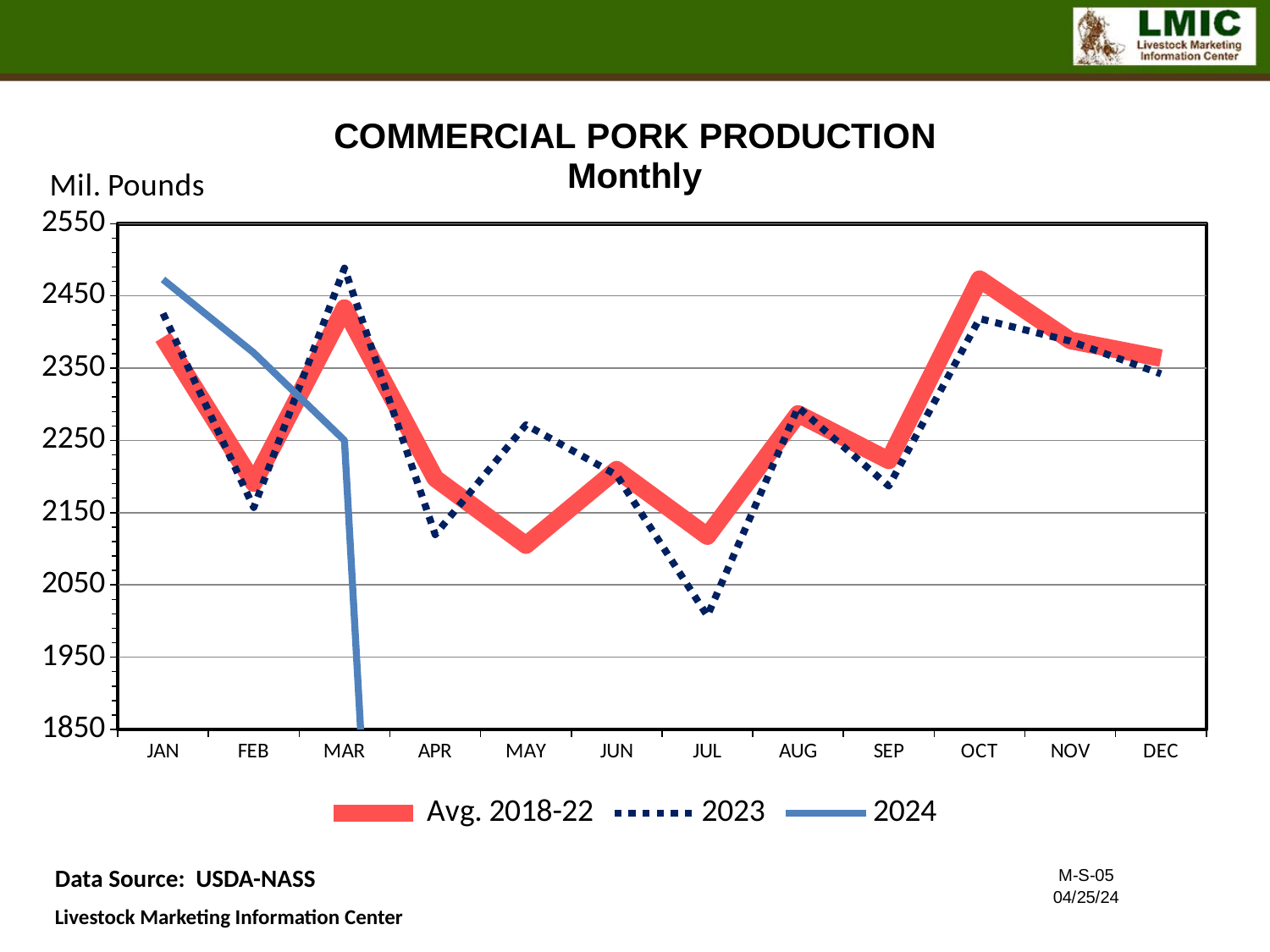
In which month does the 2023 series reach its lowest value? JUL In which month does the Avg. 2018-22 series reach its highest value? OCT Does the 2024 series rise or fall from JAN to MAR? fall In JAN, which series has the higher value, 2024 or Avg. 2018-22? 2024 Is the 2023 value for JUL greater or less than 2050? less In which month does the 2023 series reach its highest value? MAR Is the 2023 value for MAR greater or less than 2450? greater How many series does the legend list? 3 What kind of chart is shown on the slide? line chart How many months are shown along the x axis? 12 Is the Avg. 2018-22 value for MAY greater or less than 2150? less What unit is shown on the y axis label? Mil. Pounds